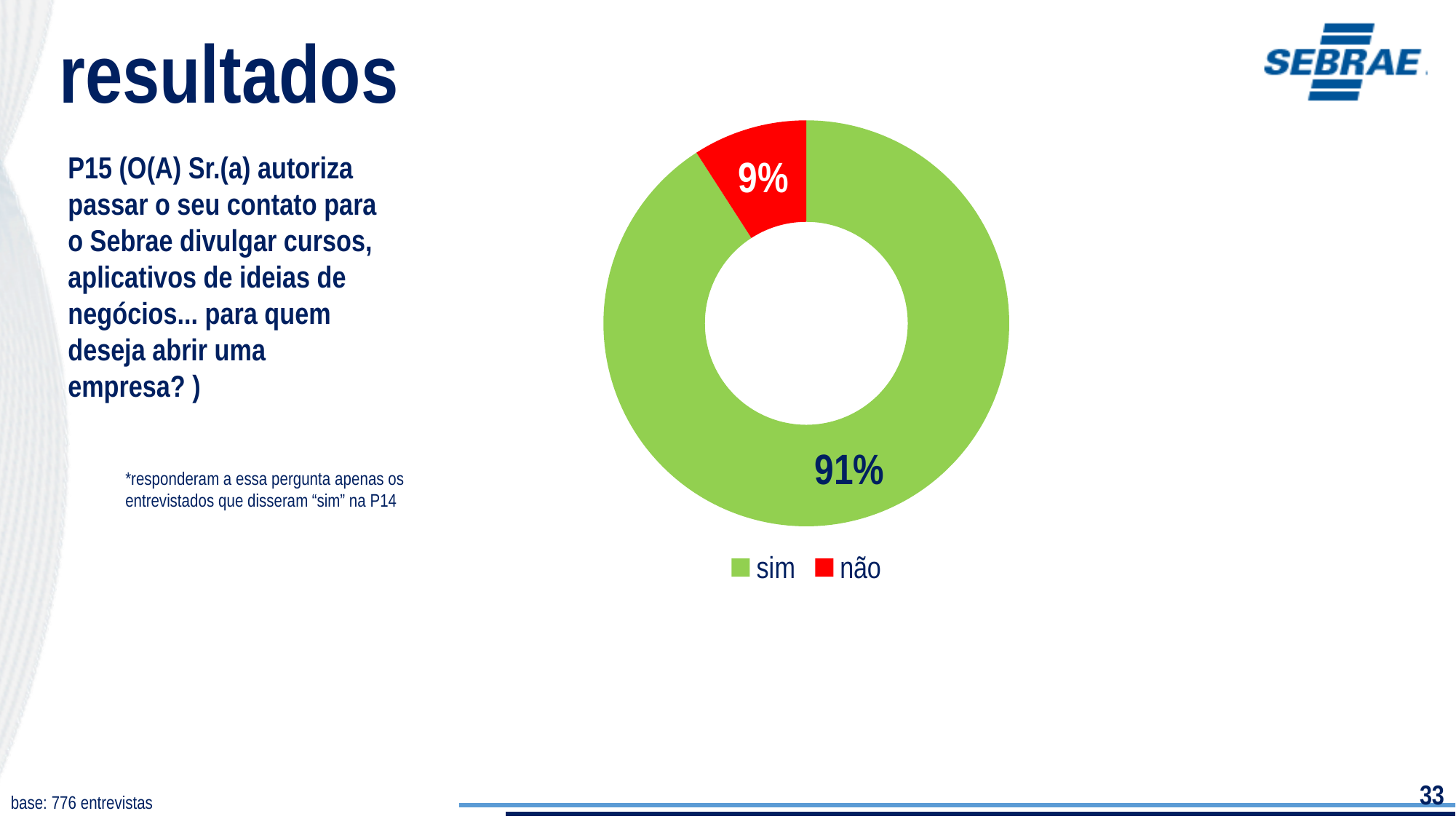
What kind of chart is shown on the slide? Pie chart (doughnut) How many entries does the legend list? 2 Which response has the largest share of the chart? sim What percentage of respondents answered "não"? 9% What is the difference in percentage points between "sim" and "não"? 82 What percentage of respondents answered "sim"? 91% What colour is the "sim" slice? Green What colour is the "não" slice? Red What share of the pie does the "não" slice represent? 9% How many slices does the chart have? 2 Which is larger, the share for "sim" or the share for "não"? sim Which response has the smallest share of the chart? não